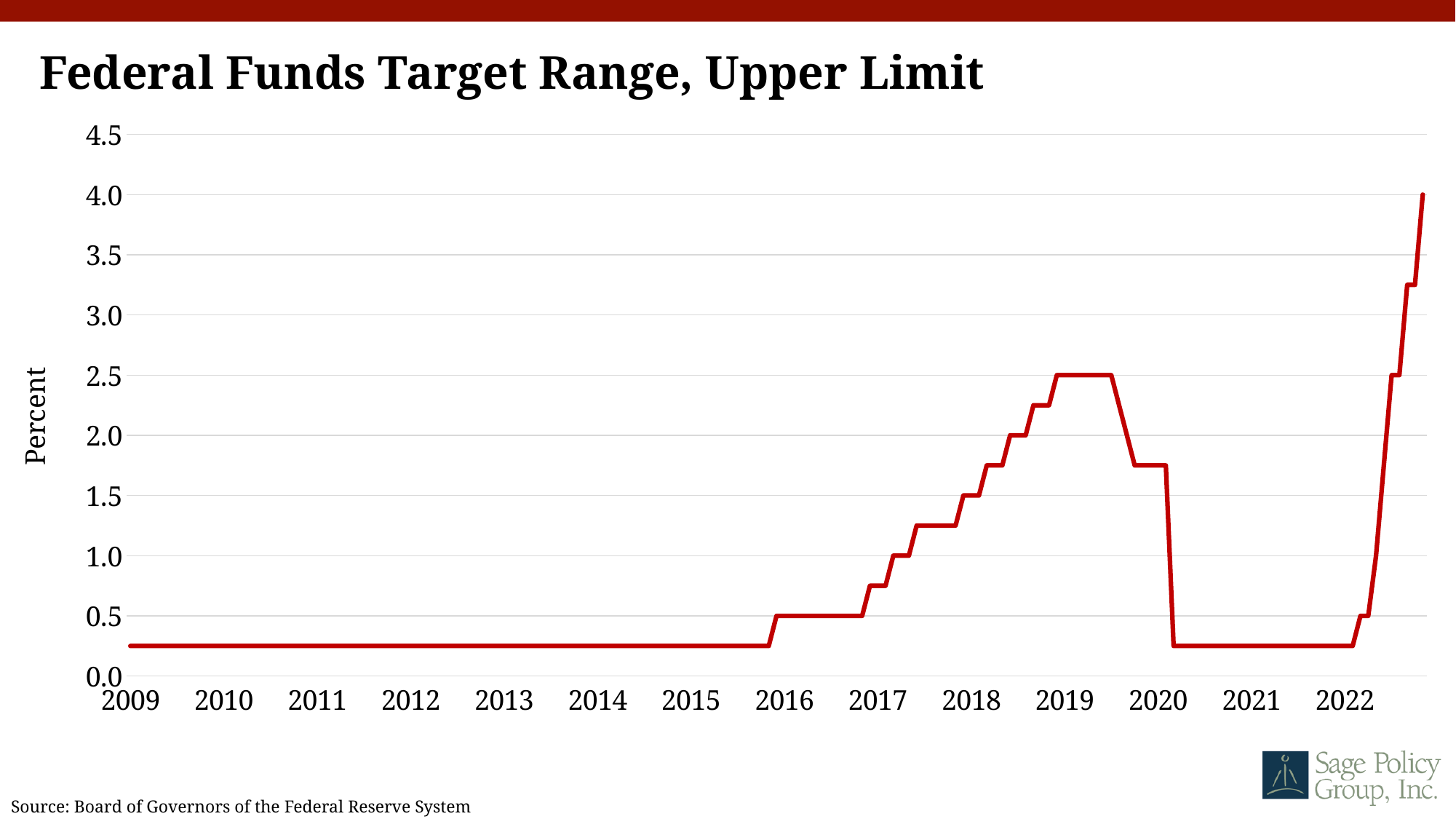
Which is higher, the value in early 2019 or the value in 2021? early 2019 What value does the line plateau at during the first half of 2019? 2.5 Does the line rise or fall between 2016 and 2019? rise What is the highest value the line reaches at the end of 2022? 4.0 Is the value at the start of 2009 greater or less than 0.5? less What is the title of the chart? Federal Funds Target Range, Upper Limit Is the value in mid-2017 greater or less than 2.0? less Is the value in 2021 greater or less than 0.5? less What type of chart is shown on the slide? line chart What is the label on the vertical axis? Percent Does the line rise or fall during 2022? rise